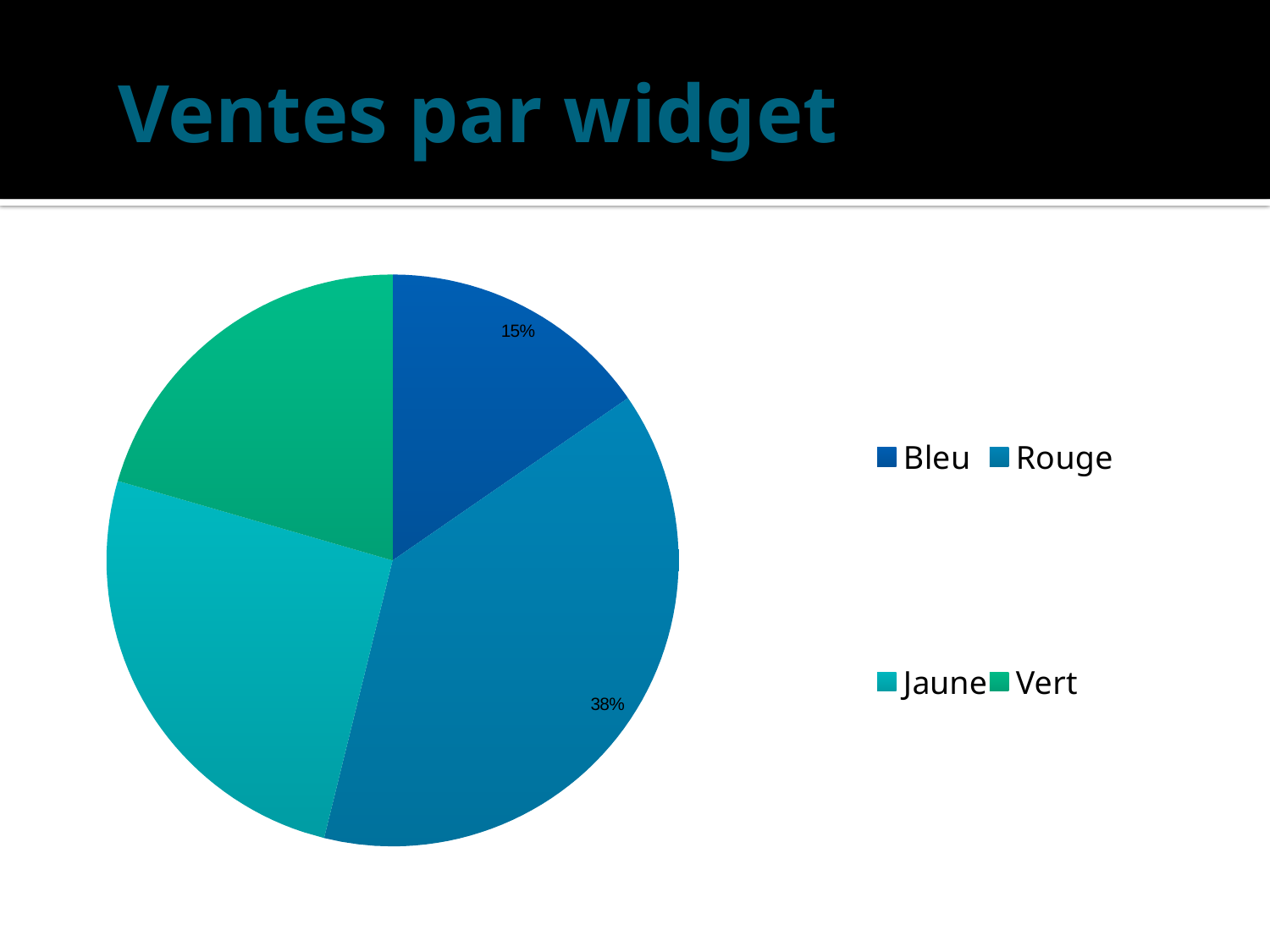
Which category has the smallest slice of the pie? Bleu By how many percentage points does the Rouge share exceed the Bleu share? 23 What share of the pie does the Rouge slice represent? 38% What share of the pie does the Bleu slice represent? 15% How many slices does the pie chart have? 4 Which category has the largest slice of the pie? Rouge What is the title of the chart on the slide? Ventes par widget What kind of chart is shown on the slide? pie chart Which slice is larger, Rouge or Bleu? Rouge Which slice is larger, Rouge or Jaune? Rouge Which legend entries are listed in the chart? Bleu, Rouge, Jaune, Vert How many entries does the legend list? 4